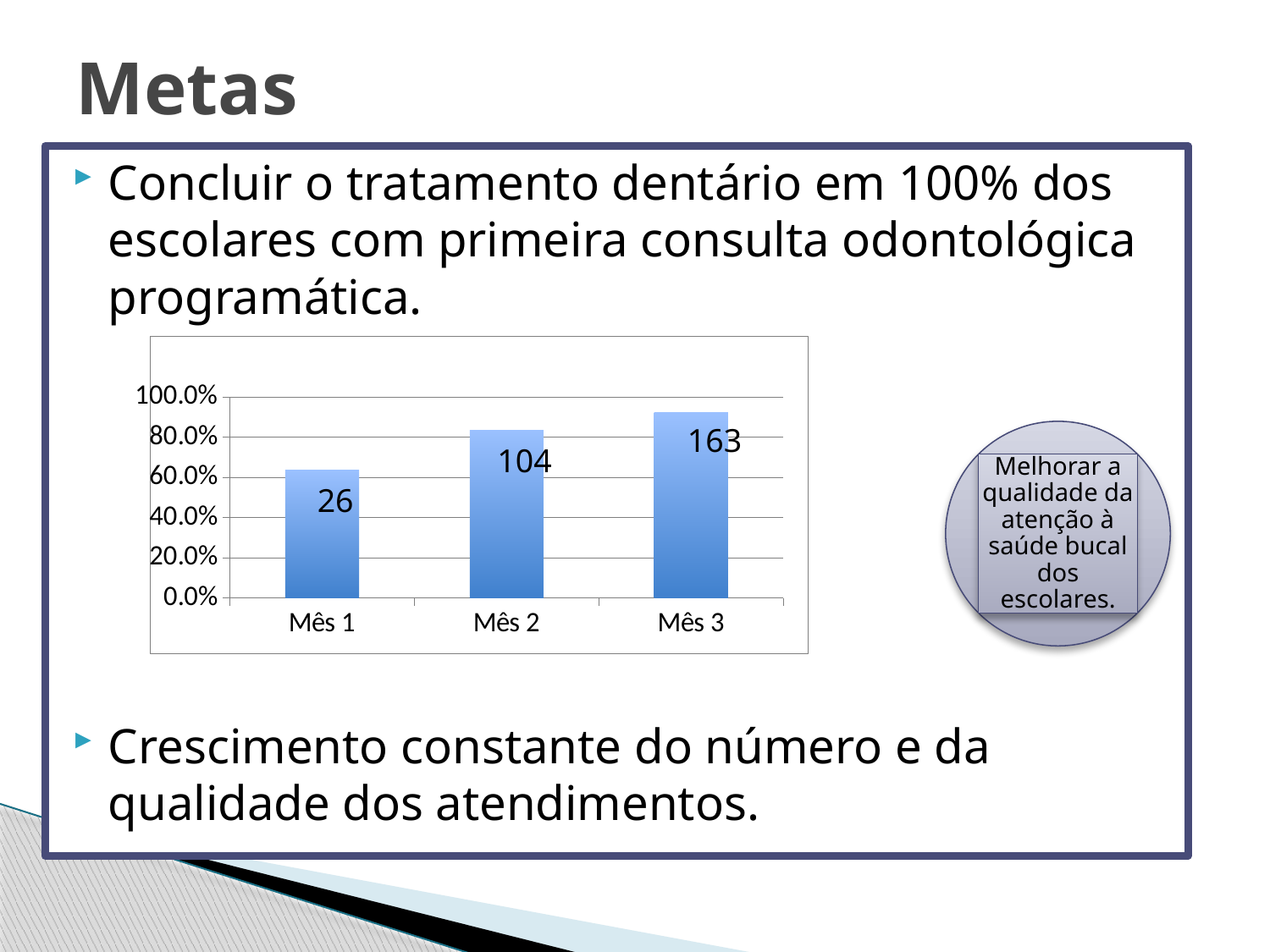
What is the difference between the data labels for Mês 3 and Mês 2? 59 What data label is printed on the bar for Mês 1? 26 How many categories (months) are plotted on the chart? 3 What is the difference between the data labels for Mês 2 and Mês 1? 78 Which month has the lowest bar? Mês 1 Is the bar for Mês 3 greater or less than 80.0% on the axis? greater What kind of chart is shown on the slide? bar chart What data label is printed on the bar for Mês 2? 104 Which bar is taller, Mês 1 or Mês 2? Mês 2 Do the bar heights rise or fall from Mês 1 to Mês 3? rise Which month has the highest bar? Mês 3 What data label is printed on the bar for Mês 3? 163